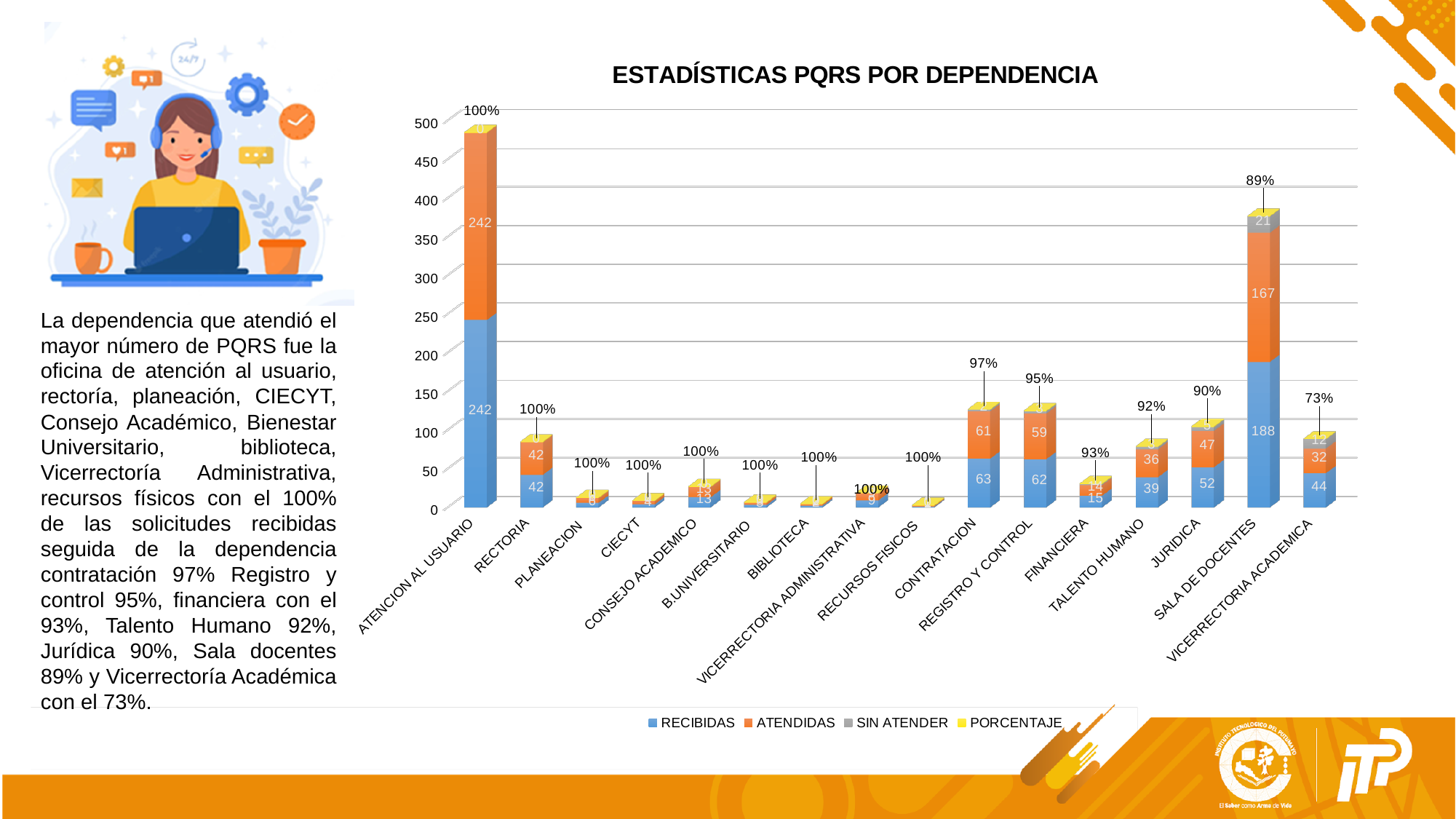
Which dependencia has the lowest PORCENTAJE label? VICERRECTORIA ACADEMICA Which dependencia has the highest RECIBIDAS value? ATENCION AL USUARIO How many RECIBIDAS does the chart show for SALA DE DOCENTES? 188 How many series does the legend list? 4 What is the PORCENTAJE value shown for VICERRECTORIA ACADEMICA? 73% Which has more RECIBIDAS, ATENCION AL USUARIO or SALA DE DOCENTES? ATENCION AL USUARIO What is the ATENDIDAS value for CONTRATACION? 61 How many dependencias are shown on the x axis? 16 What is the total of the stacked bar for SALA DE DOCENTES (RECIBIDAS + ATENDIDAS + SIN ATENDER)? 376 What is the SIN ATENDER value for SALA DE DOCENTES? 21 Is the total height of the stacked bar for ATENCION AL USUARIO greater or less than 450? greater What is the difference between RECIBIDAS and ATENDIDAS for JURIDICA? 5